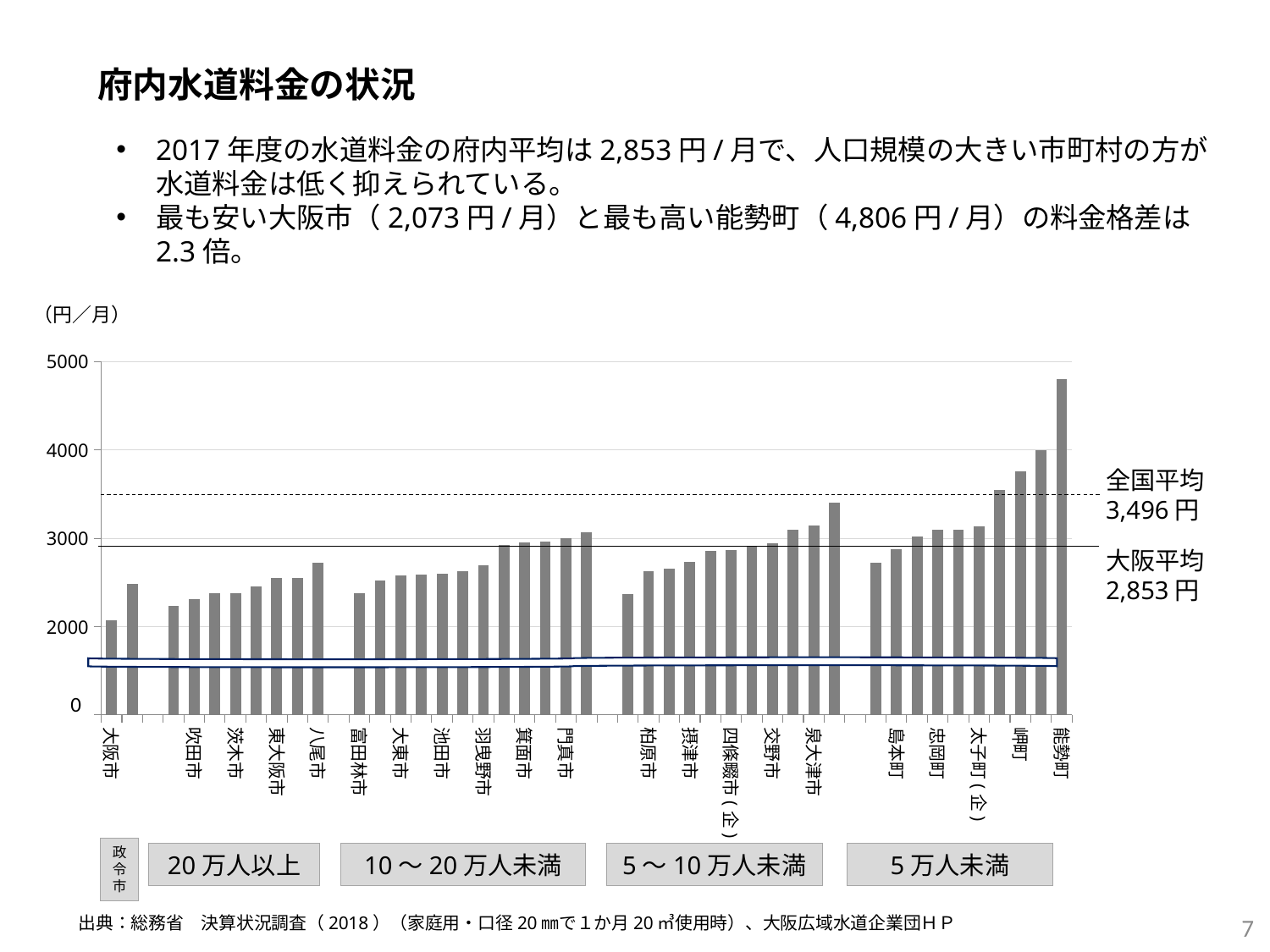
What is the difference between the water rate of 能勢町 and that of 大阪市? 2,733円/月 Is the value for 吹田市 greater or less than 3000? less What kind of chart is shown on the slide? bar chart Which municipality has the lowest water rate in the chart? 大阪市 Within the 20万人以上 group, do the bars rise or fall from left to right? rise What value is given for the 全国平均 reference line? 3,496円 What is the monthly water rate for 大阪市 as stated on the slide? 2,073円/月 Which has the higher water rate, 泉大津市 or 八尾市? 泉大津市 Which municipality has the highest water rate in the chart? 能勢町 Is the value for 岬町 greater or less than 3000? greater What is the monthly water rate for 能勢町 as stated on the slide? 4,806円/月 What value is given for the 大阪平均 reference line? 2,853円